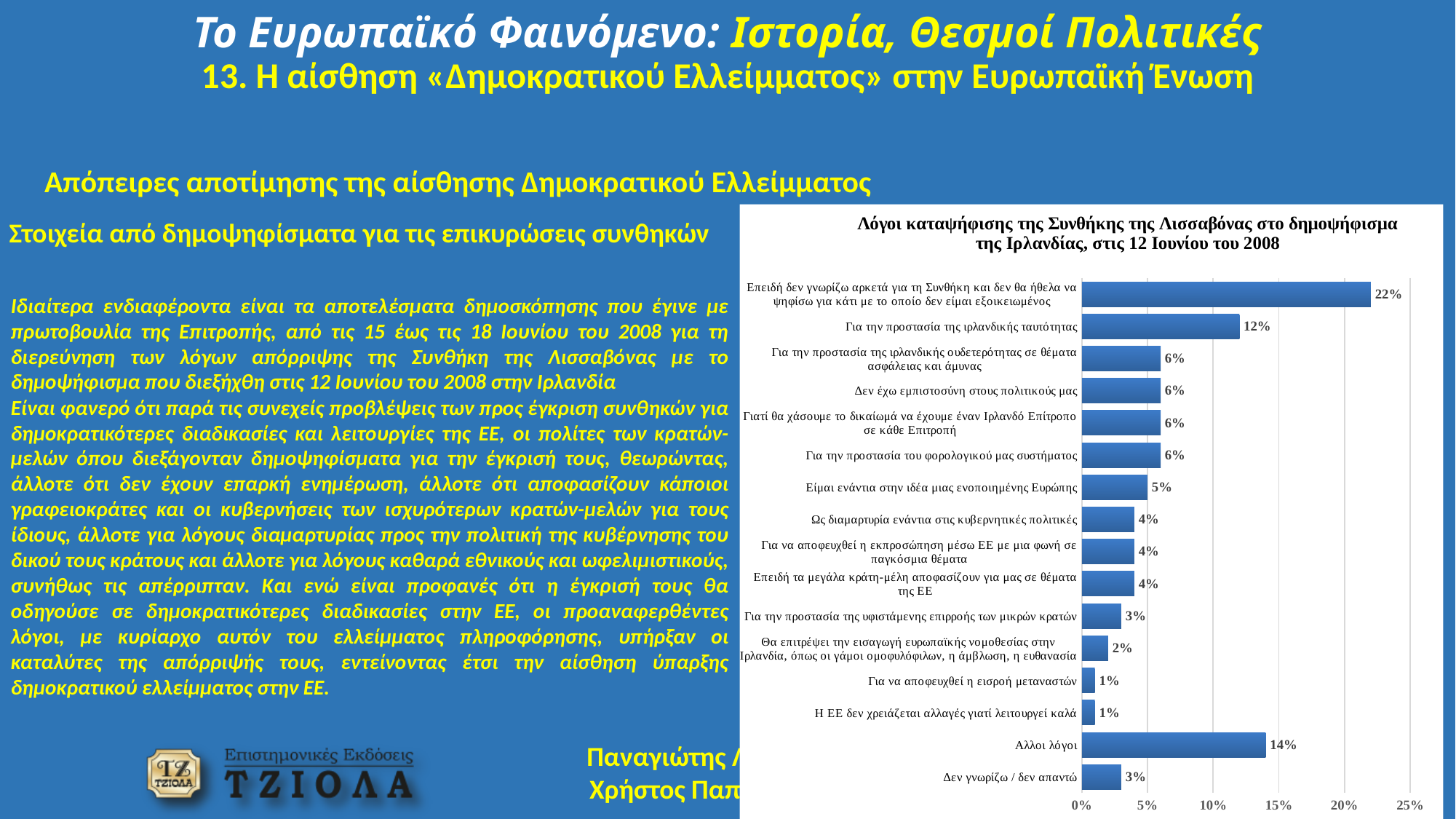
What type of chart is shown on the slide? bar chart What is the value for 'Για να αποφευχθεί η εισροή μεταναστών'? 1% What is the value for 'Δεν γνωρίζω / δεν απαντώ'? 3% What is the difference between the value for 'Επειδή δεν γνωρίζω αρκετά για τη Συνθήκη...' (22%) and 'Για την προστασία της ιρλανδικής ταυτότητας' (12%)? 10% Which is larger: the value for 'Άλλοι λόγοι' or the value for 'Για την προστασία της ιρλανδικής ταυτότητας'? Άλλοι λόγοι What is the value for 'Είμαι ενάντια στην ιδέα μιας ενοποιημένης Ευρώπης'? 5% Which category has the highest value? Επειδή δεν γνωρίζω αρκετά για τη Συνθήκη και δεν θα ήθελα να ψηφίσω για κάτι με το οποίο δεν είμαι εξοικειωμένος What is the title of the chart? Λόγοι καταψήφισης της Συνθήκης της Λισσαβόνας στο δημοψήφισμα της Ιρλανδίας, στις 12 Ιουνίου του 2008 What is the value for 'Για την προστασία της ιρλανδικής ταυτότητας'? 12% What is the value for 'Άλλοι λόγοι'? 14% Is the value for 'Επειδή δεν γνωρίζω αρκετά για τη Συνθήκη...' greater or less than 20%? greater How many categories are shown in the chart? 16